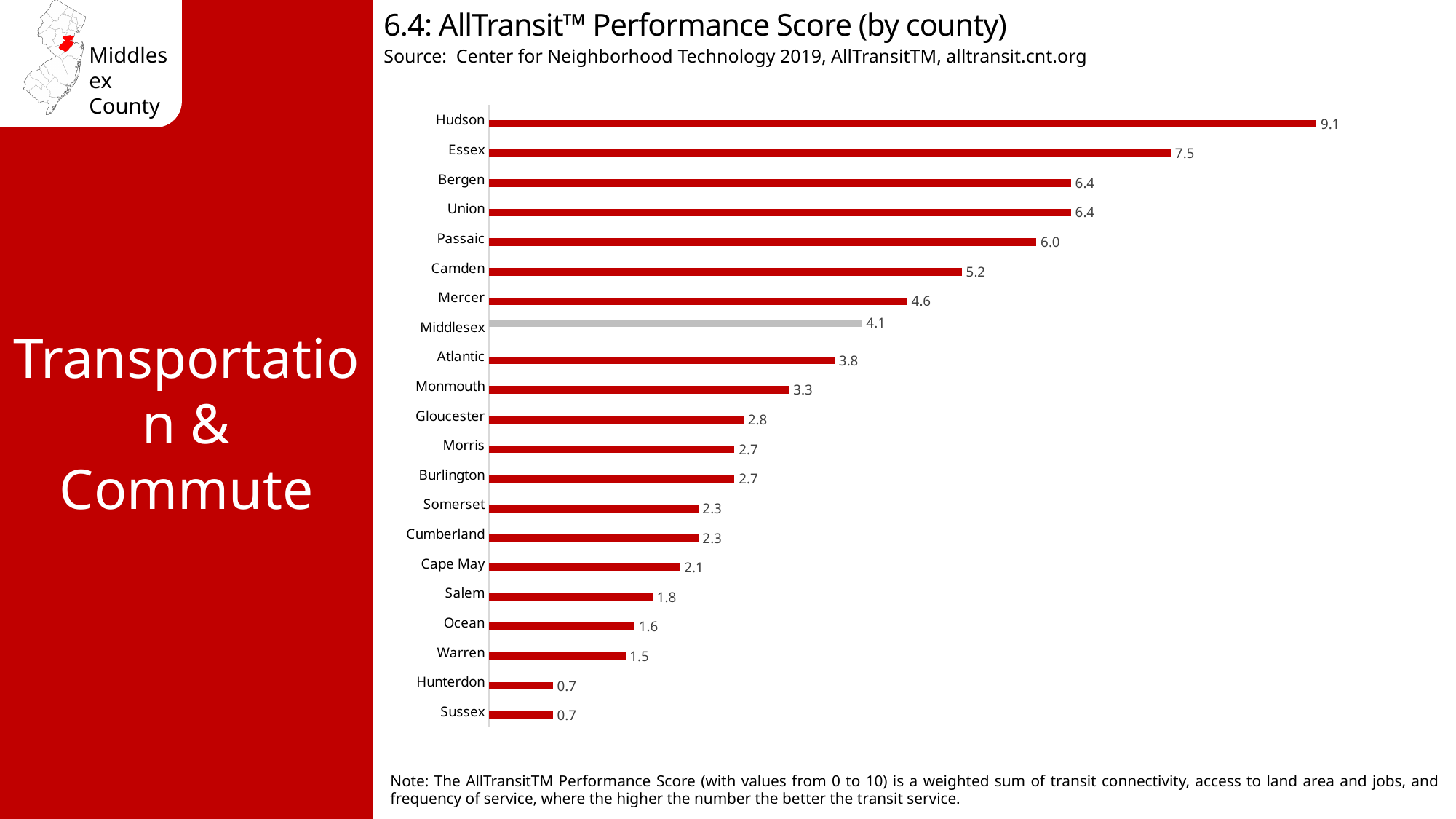
Which has a higher score, Passaic or Camden? Passaic What is the difference between the scores for Hudson and Essex? 1.6 What kind of chart is shown on the slide? Bar chart What is the difference between the scores for Mercer and Middlesex? 0.5 What is the AllTransit Performance Score for Middlesex? 4.1 What is the AllTransit Performance Score for Monmouth? 3.3 Which has a higher score, Atlantic or Somerset? Atlantic Which county's bar is shown in grey rather than red? Middlesex What is the title of the chart? 6.4: AllTransit™ Performance Score (by county) What is the AllTransit Performance Score for Hudson? 9.1 Which county has the highest AllTransit Performance Score? Hudson How many counties are shown in the chart? 21